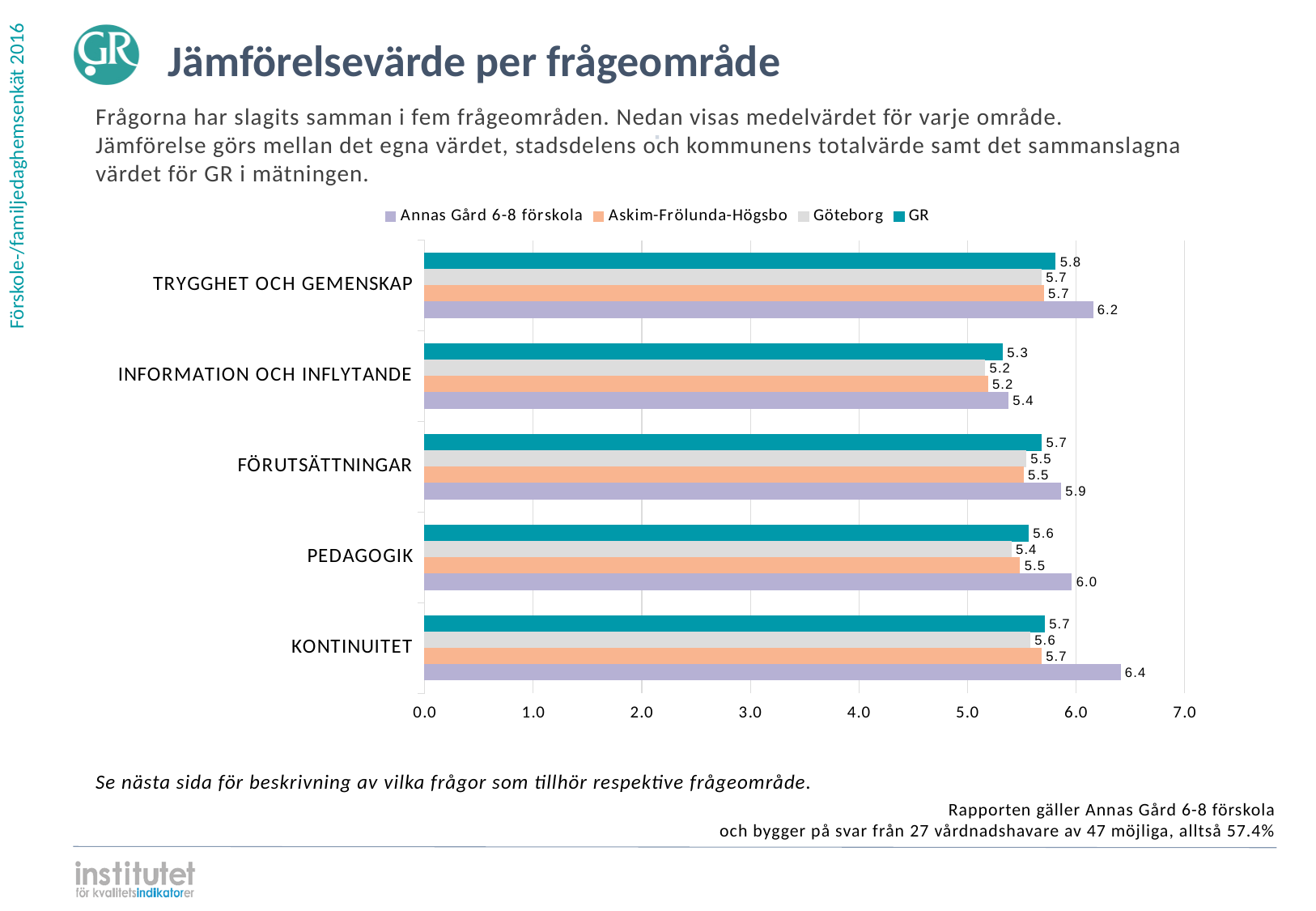
How many series does the legend list? 4 How many question areas (categories) are shown on the chart? 5 What is the value for Annas Gård 6-8 förskola in KONTINUITET? 6.4 In PEDAGOGIK, which is larger: the value for Annas Gård 6-8 förskola or the value for Göteborg? Annas Gård 6-8 förskola What is the value for GR in INFORMATION OCH INFLYTANDE? 5.3 What is the value for Göteborg in PEDAGOGIK? 5.4 In which category does Annas Gård 6-8 förskola have its lowest value? INFORMATION OCH INFLYTANDE In which category does Annas Gård 6-8 förskola have its highest value? KONTINUITET What is the value for Askim-Frölunda-Högsbo in FÖRUTSÄTTNINGAR? 5.5 What is the title of the chart on the slide? Jämförelsevärde per frågeområde What kind of chart is shown on the slide? Bar chart What is the difference between the Annas Gård 6-8 förskola value and the GR value in TRYGGHET OCH GEMENSKAP? 0.4